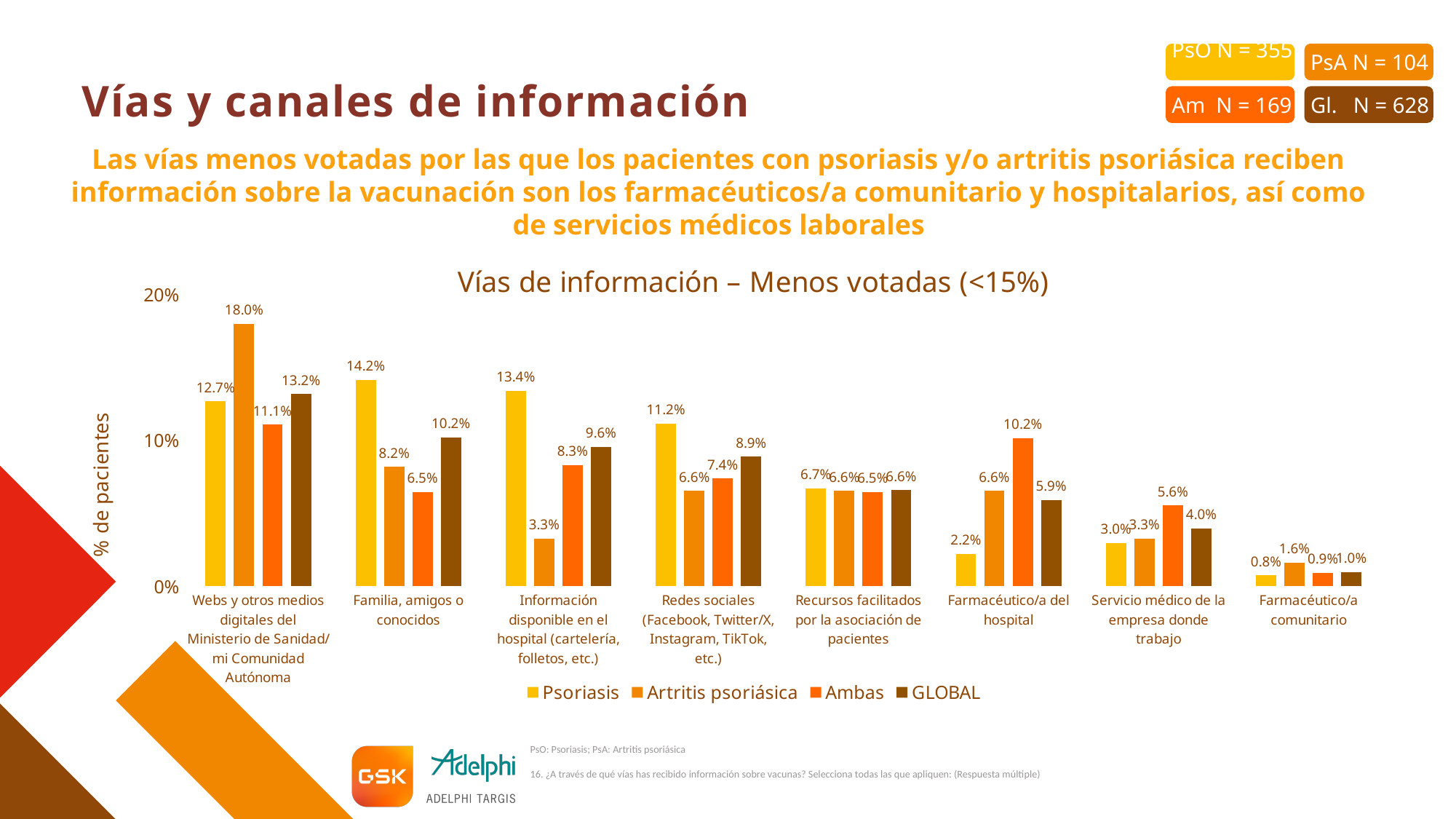
Which category has the highest Psoriasis value? Familia, amigos o conocidos For 'Servicio médico de la empresa donde trabajo', which is larger: the Ambas value or the GLOBAL value? Ambas What is the difference between the Psoriasis and Artritis psoriásica values for 'Información disponible en el hospital (cartelería, folletos, etc.)'? 10.1% What type of chart is shown on the slide? bar chart What is the title of the chart? Vías de información – Menos votadas (<15%) Which category has the lowest GLOBAL value? Farmacéutico/a comunitario What is the GLOBAL value for 'Familia, amigos o conocidos'? 10.2% Is the Psoriasis value for 'Redes sociales (Facebook, Twitter/X, Instagram, TikTok, etc.)' greater or less than 10%? greater How many series does the legend list? 4 What is the Ambas value for 'Farmacéutico/a del hospital'? 10.2% How many categories are shown on the x axis? 8 What is the Artritis psoriásica value for 'Webs y otros medios digitales del Ministerio de Sanidad/mi Comunidad Autónoma'? 18.0%